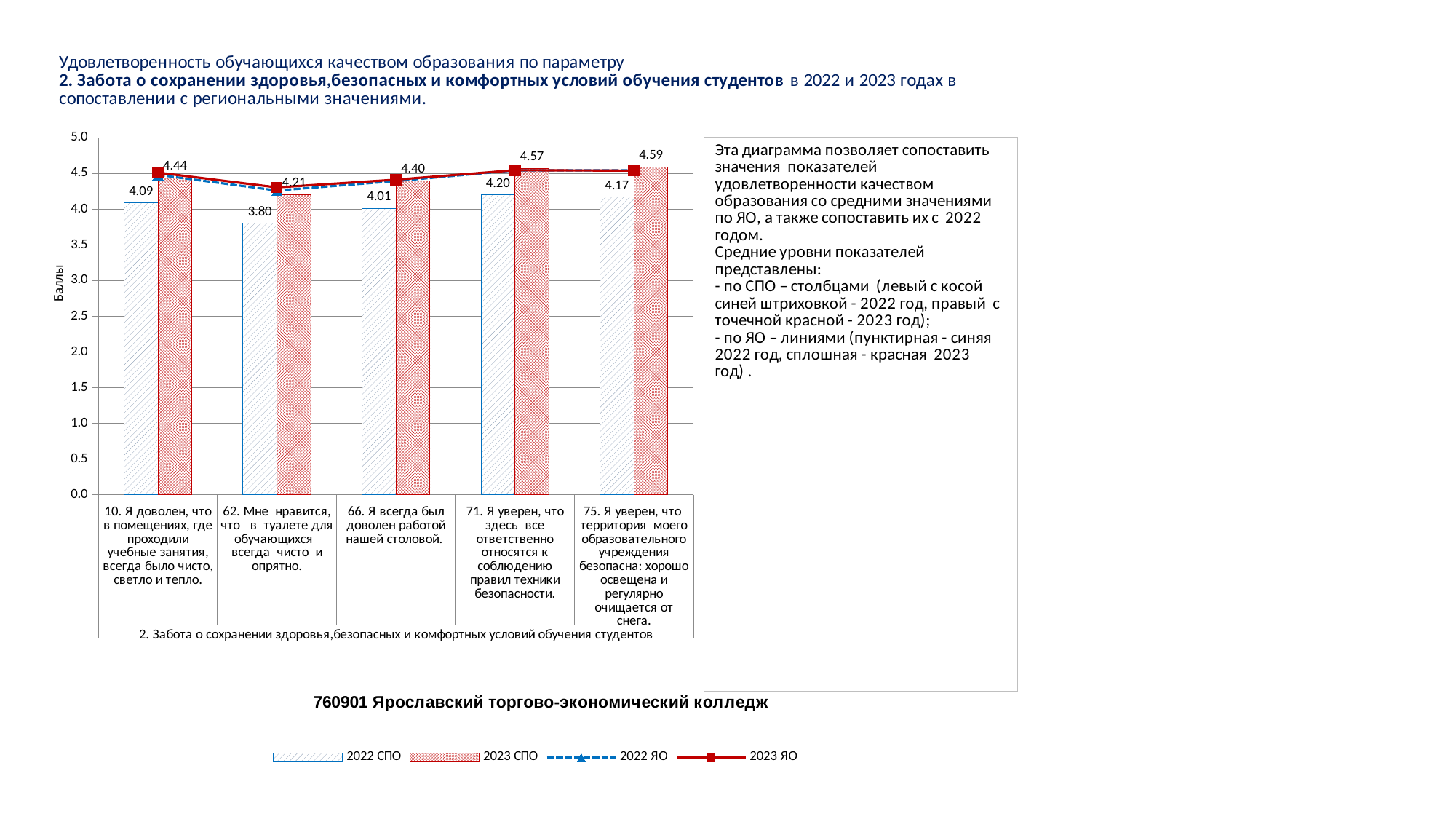
Is the 2022 СПО value for question 62 greater or less than 4.0? less How many questions (categories) are shown on the x axis of the chart? 5 For question 71, which is larger: the 2022 СПО value or the 2023 СПО value? 2023 СПО Which question has the lowest 2022 СПО value? 62. Мне нравится, что в туалете для обучающихся всегда чисто и опрятно What is the label of the vertical axis of the chart? Баллы How many series does the chart legend list? 4 What is the 2023 СПО value for question 62 ("Мне нравится, что в туалете для обучающихся всегда чисто и опрятно")? 4.21 What kind of chart is shown on the slide? Combined bar and line chart What is the difference between the 2023 СПО and 2022 СПО values for question 10? 0.35 What is the 2022 СПО value for question 75 (territory of the educational institution is safe)? 4.17 What is the 2022 СПО value for question 66 ("Я всегда был доволен работой нашей столовой")? 4.01 Which question has the highest 2023 СПО value? 75. Я уверен, что территория моего образовательного учреждения безопасна